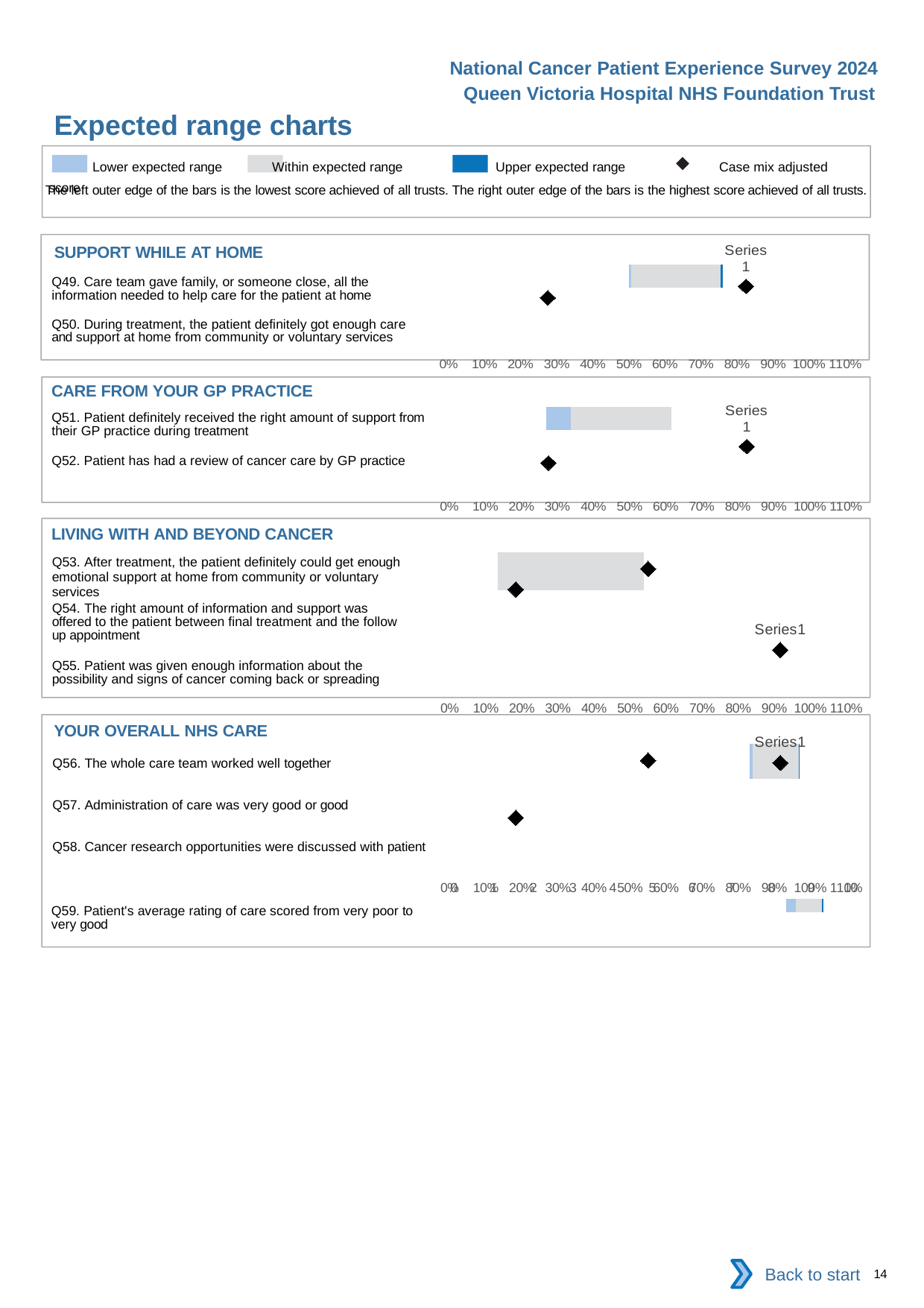
How many questions are listed in the YOUR OVERALL NHS CARE chart? 4 How many questions are listed in the SUPPORT WHILE AT HOME chart? 2 How many questions are listed in the CARE FROM YOUR GP PRACTICE chart? 2 What kind of chart is used in each section of this slide? Bar chart In the CARE FROM YOUR GP PRACTICE chart, is the right edge of the expected range bar for Q51 greater or less than 50%? greater What is the highest tick label shown on the x axis of the SUPPORT WHILE AT HOME chart? 110% How many entries does the legend at the top of the slide list? 4 In the CARE FROM YOUR GP PRACTICE chart, is the case mix adjusted score marker for Q52 greater or less than 50%? less What is the lowest tick label shown on the x axis of the CARE FROM YOUR GP PRACTICE chart? 0% What symbol does the legend use for the case mix adjusted score? A black diamond